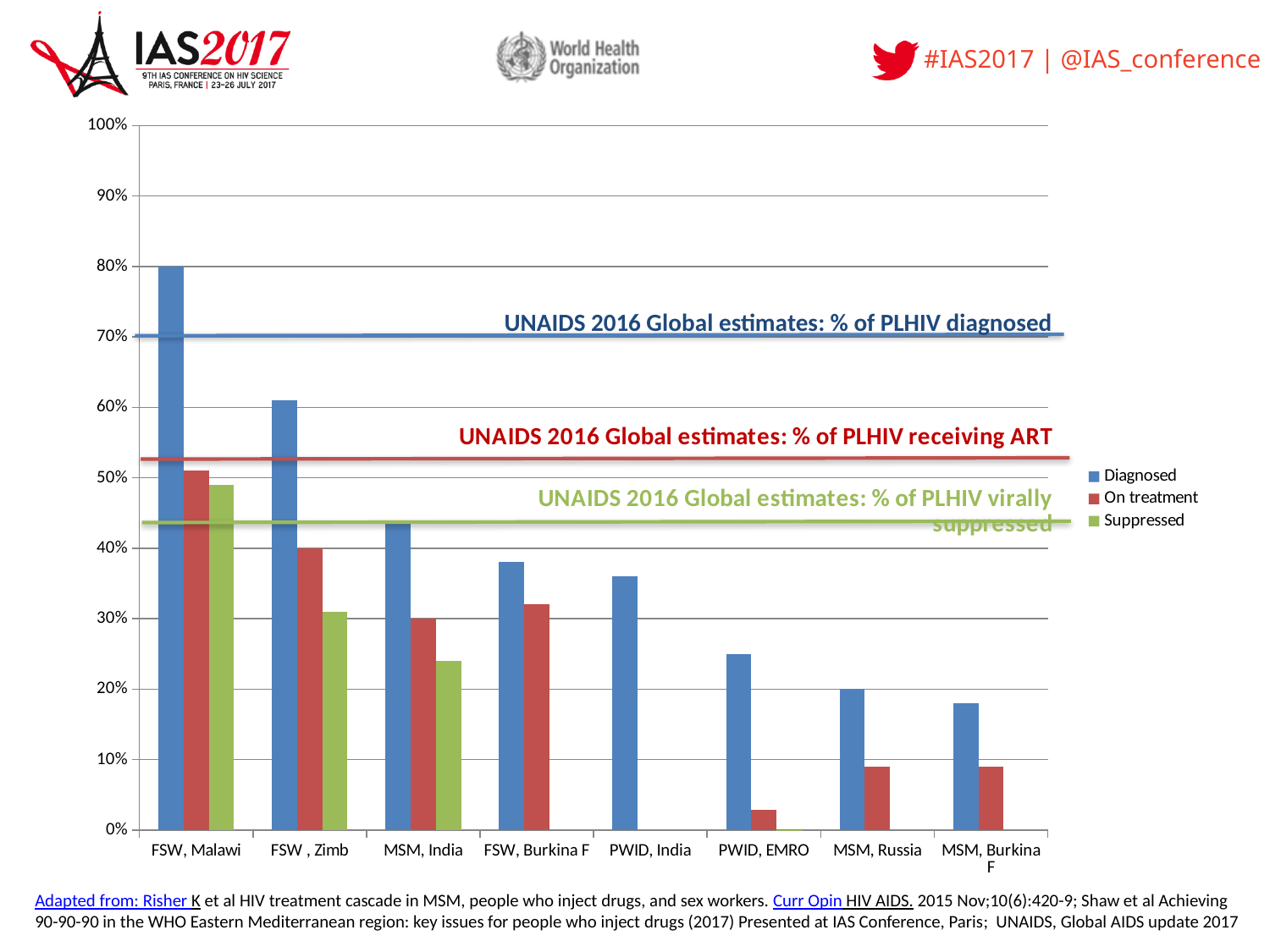
Is the Diagnosed value for FSW, Zimb greater or less than 50%? greater How many series does the legend list? 3 Is the On treatment value for MSM, Russia greater or less than 10%? less How many categories have a Suppressed bar plotted? 3 Do the Diagnosed values rise or fall moving from left to right along the x axis? fall Is the On treatment value for PWID, EMRO greater or less than 10%? less Which has the larger Suppressed value, FSW, Malawi or FSW, Zimb? FSW, Malawi Which category has the lowest Diagnosed value? MSM, Burkina F What kind of chart is shown on the slide? bar chart Which category has the highest Diagnosed value? FSW, Malawi How many population categories are shown along the x axis? 8